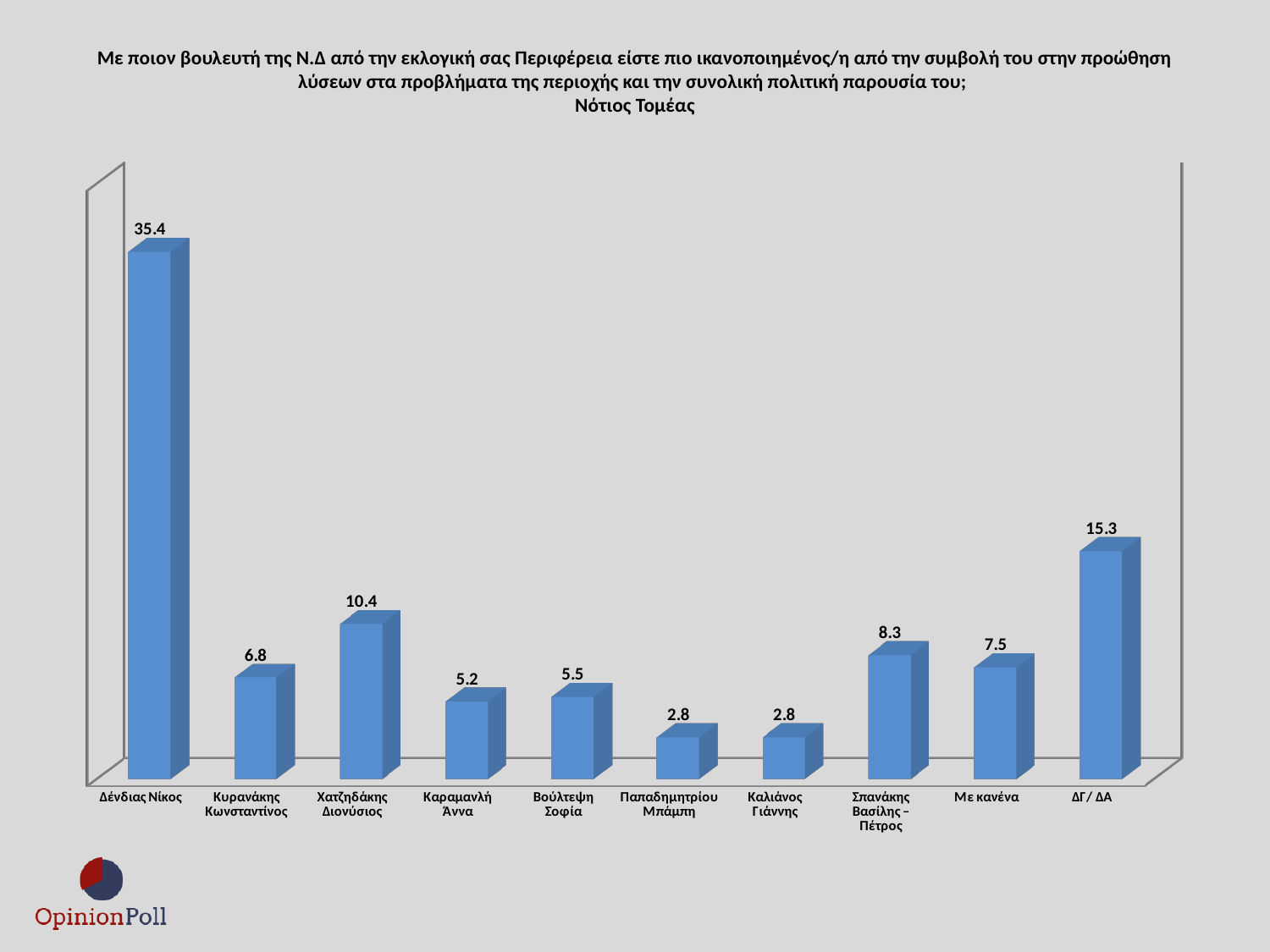
How many categories are shown on the x axis? 10 What is the difference between the values for Χατζηδάκης Διονύσιος and Καραμανλή Άννα? 5.2 Which category has the highest value? Δένδιας Νίκος What is the difference between the values for Δένδιας Νίκος and ΔΓ/ ΔΑ? 20.1 Which is larger, the value for Κυρανάκης Κωνσταντίνος or the value for Σπανάκης Βασίλης – Πέτρος? Σπανάκης Βασίλης – Πέτρος What is the value for Χατζηδάκης Διονύσιος? 10.4 What is the value for Με κανένα? 7.5 Which region is named in the chart title? Νότιος Τομέας What is the value for Δένδιας Νίκος? 35.4 What is the value for ΔΓ/ ΔΑ? 15.3 What kind of chart is shown on the slide? bar chart Which two categories share the lowest value of 2.8? Παπαδημητρίου Μπάμπη and Καλιάνος Γιάννης